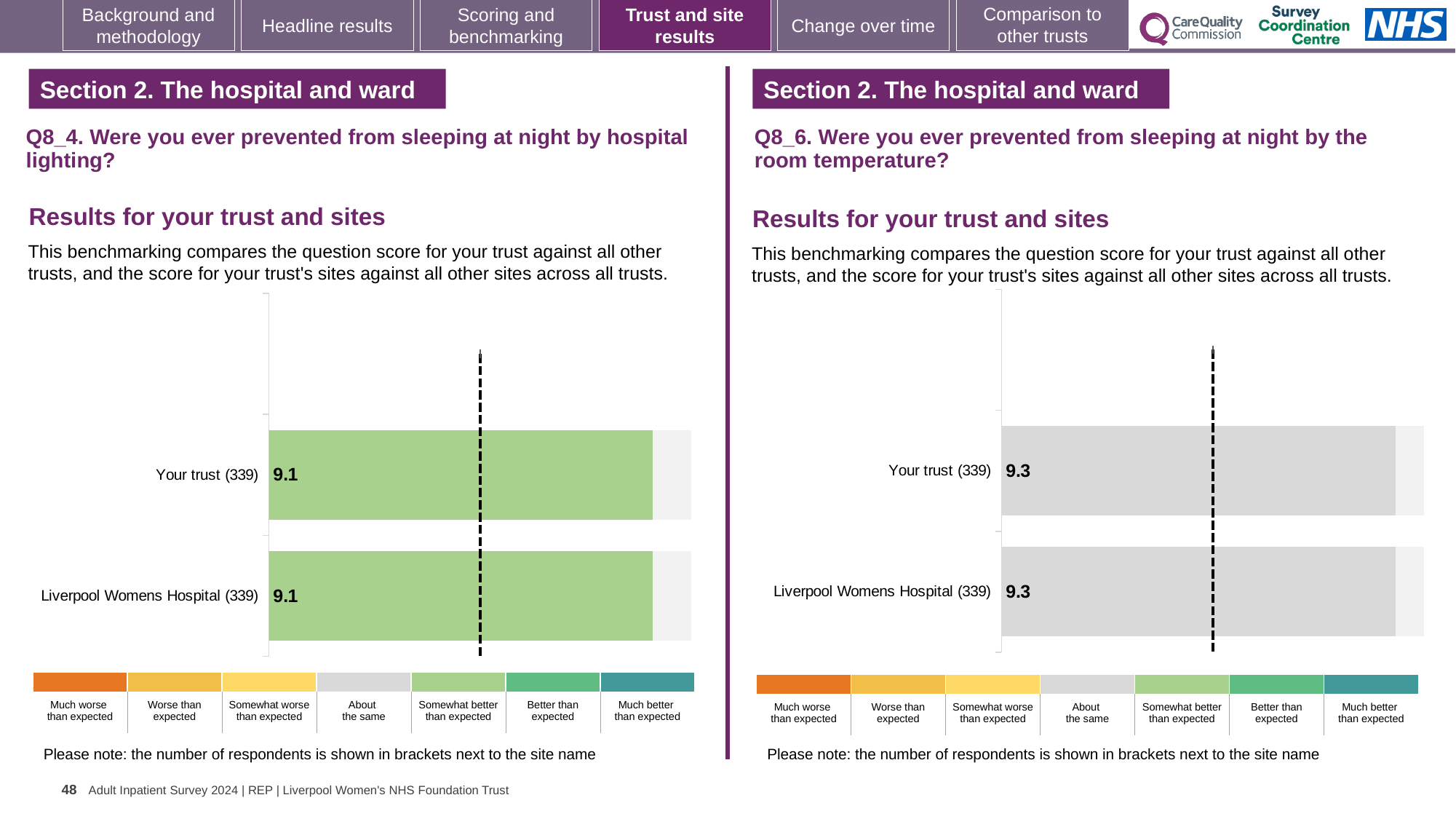
How many bars are plotted on the Q8_4 hospital lighting chart? 2 On the Q8_6 room temperature chart, what is the difference between the Your trust score and the Liverpool Womens Hospital score? 0.0 How many bars are plotted on the Q8_6 room temperature chart? 2 How many respondents are shown in brackets for Your trust on the Q8_4 hospital lighting chart? 339 On the Q8_6 room temperature chart, what is the score for Liverpool Womens Hospital (339)? 9.3 What kind of chart is used for the Q8_6 room temperature results? Bar chart On the Q8_4 hospital lighting chart, what is the difference between the Your trust score and the Liverpool Womens Hospital score? 0.0 On the Q8_6 room temperature chart, which benchmark category does the grey bar colour correspond to according to the legend? About the same On the Q8_6 room temperature chart, what is the score for Your trust (339)? 9.3 On the Q8_4 hospital lighting chart, which benchmark category does the green bar colour correspond to according to the legend? Somewhat better than expected On the Q8_4 hospital lighting chart, what is the score for Your trust (339)? 9.1 On the Q8_4 hospital lighting chart, what is the score for Liverpool Womens Hospital (339)? 9.1